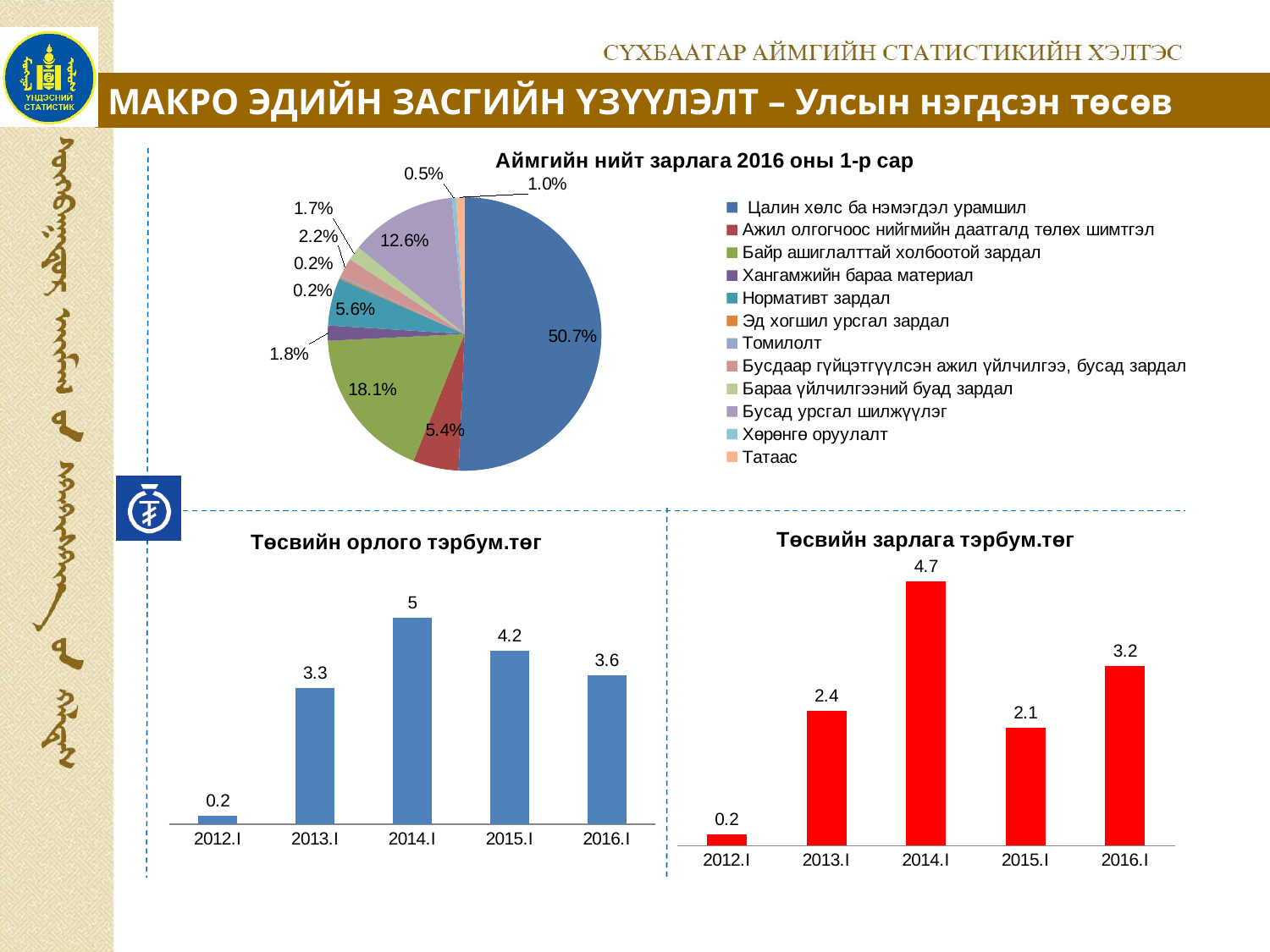
In the chart 'Төсвийн орлого тэрбум.төг', which period has the lowest value? 2012.I In the chart 'Төсвийн орлого тэрбум.төг', what is the difference between the values for 2014.I and 2015.I? 0.8 In the chart 'Төсвийн зарлага тэрбум.төг', what is the value for 2016.I? 3.2 What kind of chart is 'Төсвийн орлого тэрбум.төг'? bar chart In the chart 'Төсвийн зарлага тэрбум.төг', what colour are the bars? red In the pie chart 'Аймгийн нийт зарлага 2016 оны 1-р сар', which category has the largest slice? Цалин хөлс ба нэмэгдэл урамшил In the chart 'Төсвийн зарлага тэрбум.төг', which period has the highest value? 2014.I How many entries does the legend of the pie chart 'Аймгийн нийт зарлага 2016 оны 1-р сар' list? 12 In the pie chart 'Аймгийн нийт зарлага 2016 оны 1-р сар', what share does 'Цалин хөлс ба нэмэгдэл урамшил' have? 50.7% In the chart 'Төсвийн зарлага тэрбум.төг', which is larger: the value for 2013.I or 2015.I? 2013.I How many periods are shown on the x axis of the chart 'Төсвийн зарлага тэрбум.төг'? 5 In the chart 'Төсвийн орлого тэрбум.төг', what is the value for 2014.I? 5